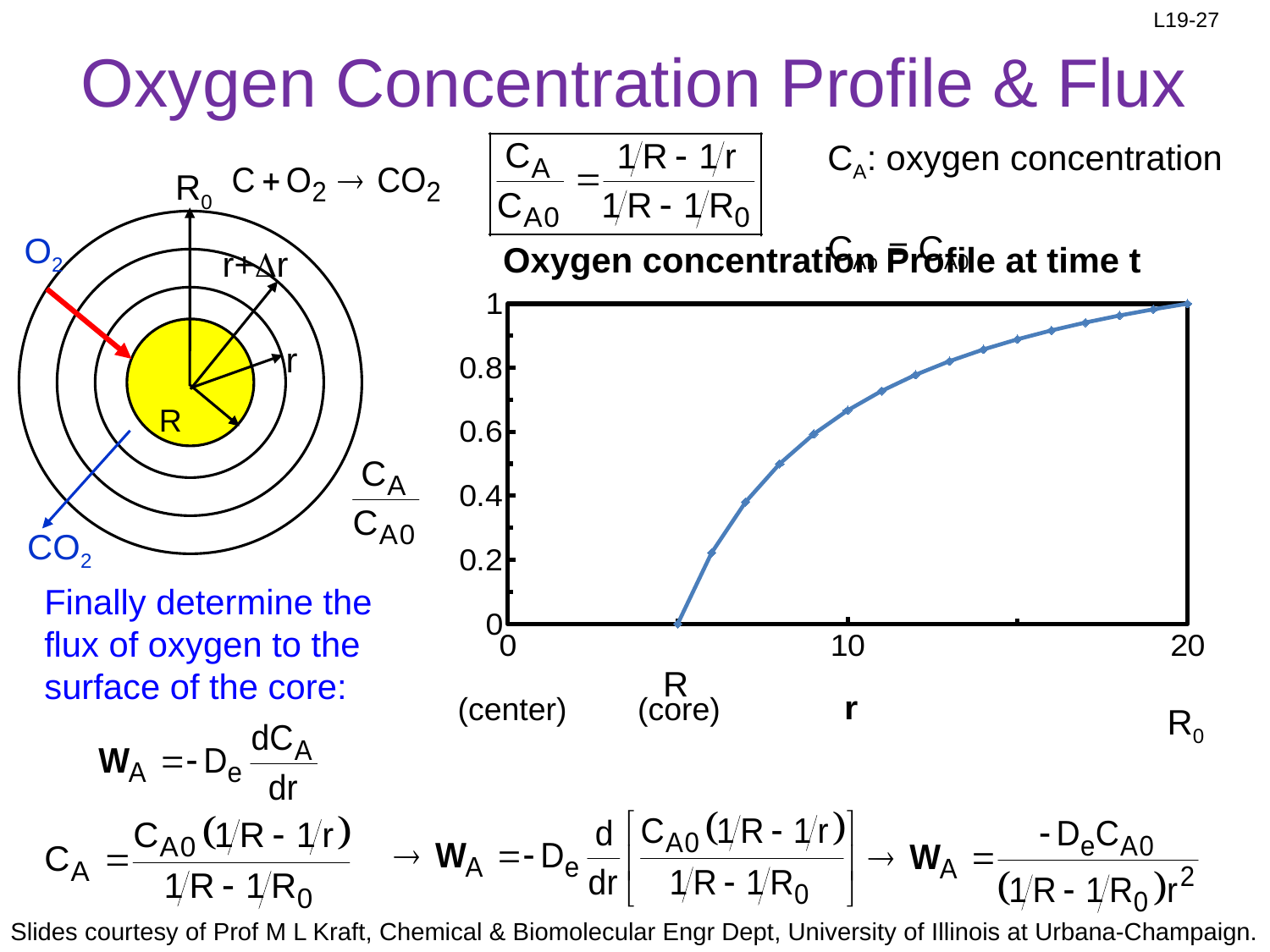
What is the value of CA/CA0 at the core surface R, where the curve starts? 0 Does the plotted value rise or fall as r increases along the x axis? rise Is the value of CA/CA0 at r = 10 greater or less than 0.4? greater At which value of r is CA/CA0 highest? 20 Is the value of CA/CA0 at r = 6 greater or less than 0.4? less What is the label on the x axis of the chart? r At which value of r is CA/CA0 lowest? R (core) Which is larger, the value of CA/CA0 at r = 10 or at r = 15? r = 15 What is the title of the chart? Oxygen concentration Profile at time t What kind of chart is shown on the slide? line chart What is the value of CA/CA0 at r = 20 (R0)? 1 Is the value of CA/CA0 at r = 15 greater or less than 0.8? greater